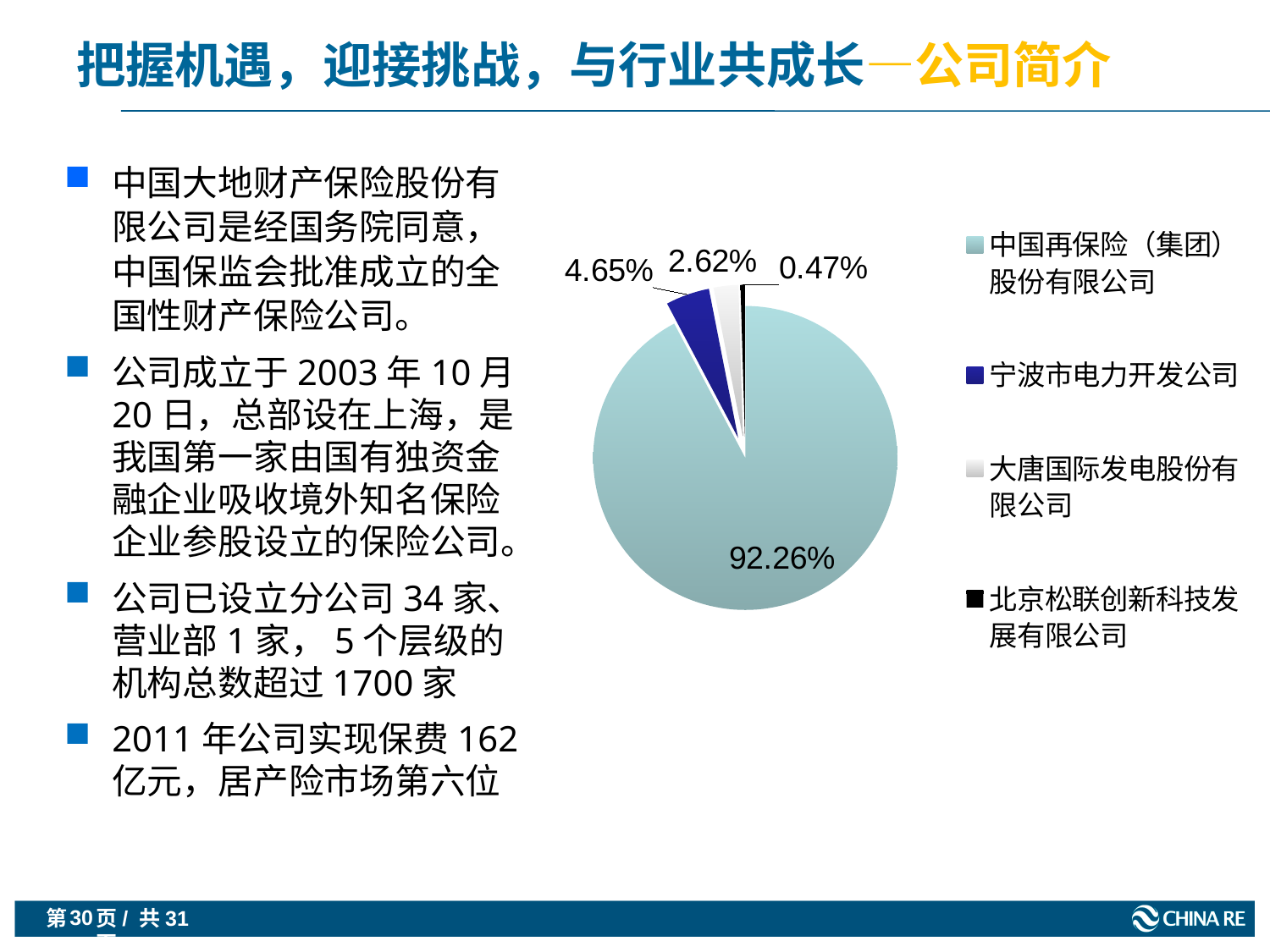
Which legend entry is shown in dark blue in the pie chart? 宁波市电力开发公司 What type of chart is shown on the slide? pie chart Which shareholder has the largest slice of the pie? 中国再保险（集团）股份有限公司 What share of the pie does 宁波市电力开发公司 hold? 4.65% What share of the pie does 大唐国际发电股份有限公司 hold? 2.62% What is the difference between the share of 宁波市电力开发公司 and the share of 大唐国际发电股份有限公司? 2.03% What share of the pie does 北京松联创新科技发展有限公司 hold? 0.47% Which shareholder has the smallest slice of the pie? 北京松联创新科技发展有限公司 Which is larger, the share of 宁波市电力开发公司 or the share of 大唐国际发电股份有限公司? 宁波市电力开发公司 How many entries does the legend of the pie chart list? 4 How many slices does the pie chart have? 4